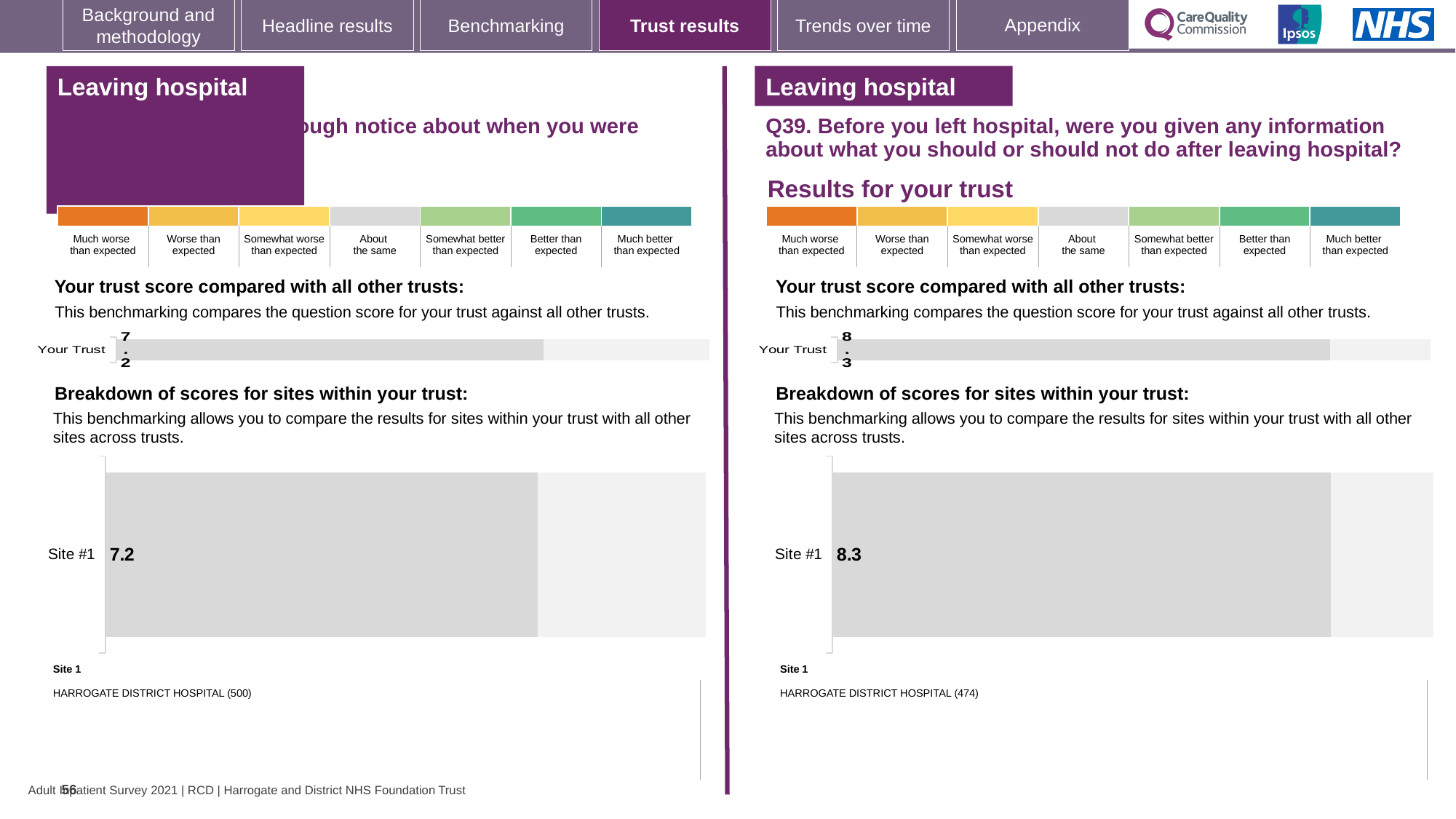
What is the difference between the Site #1 score on the right-hand Q39 chart and the Site #1 score on the left-hand chart? 1.1 On the left-hand chart, what is the score shown for Your Trust? 7.2 On the right-hand Q39 breakdown of scores for sites within your trust, what is the score for Site #1? 8.3 How many sites are shown in the left-hand breakdown of scores for sites within your trust? 1 On the right-hand Q39 chart, which site is listed as Site 1? HARROGATE DISTRICT HOSPITAL (474) What type of chart is used for the breakdown of scores for sites within your trust on the right-hand side? Bar chart How many sites are shown in the right-hand Q39 breakdown of scores for sites within your trust? 1 On the left-hand breakdown of scores for sites within your trust, what is the score for Site #1? 7.2 Which is larger: the Site #1 score on the left-hand chart or the Site #1 score on the right-hand Q39 chart? Right-hand Q39 chart (8.3) Is the Your Trust score on the right-hand Q39 chart greater or less than 8? greater On the right-hand chart for Q39, what is the score shown for Your Trust? 8.3 On the left-hand chart, which site is listed as Site 1? HARROGATE DISTRICT HOSPITAL (500)